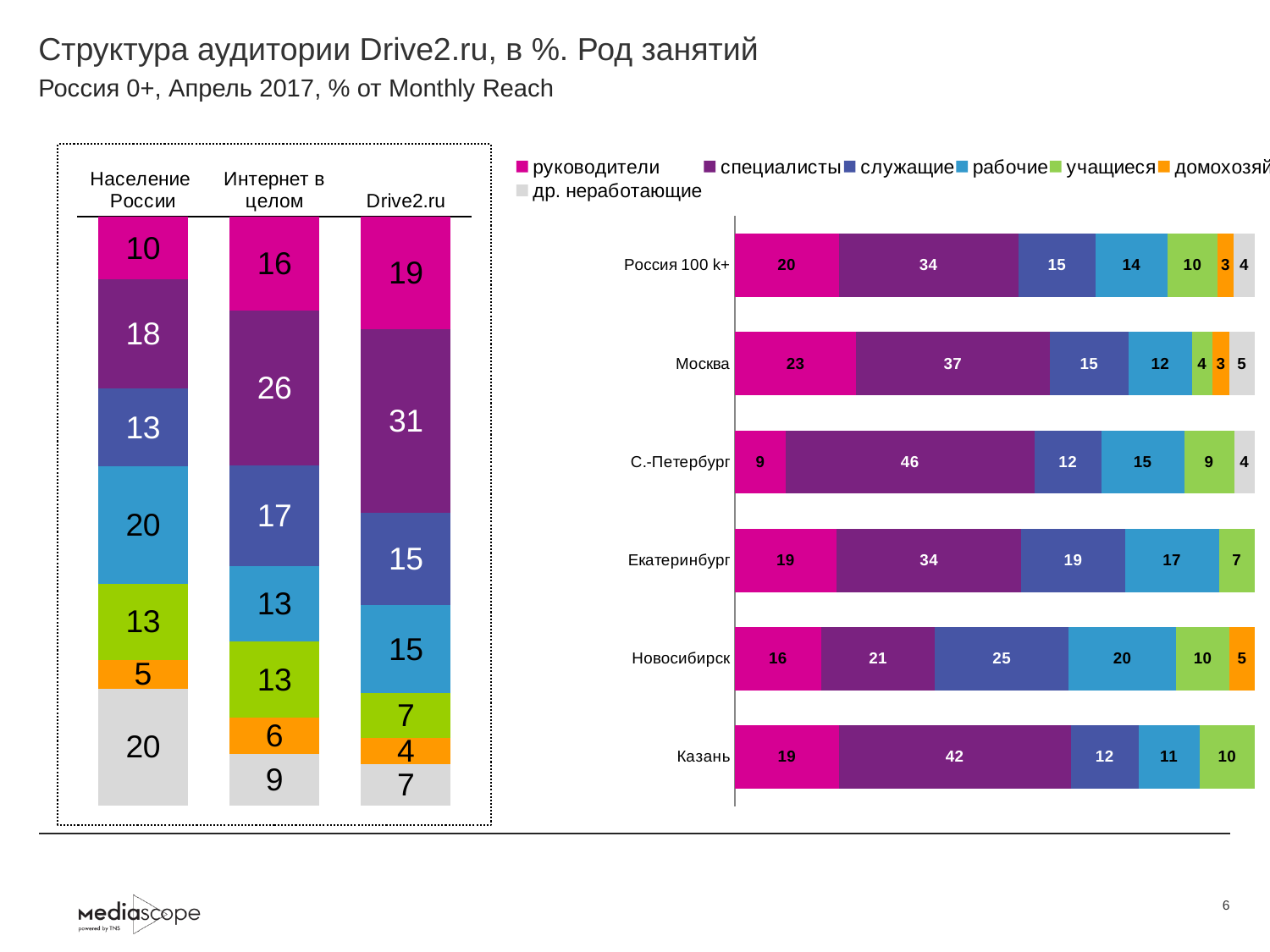
In the right chart, what is the специалисты value for С.-Петербург? 46 What type of chart is the right chart? Stacked bar chart In the left chart, is the др. неработающие (grey) value larger for Население России or for Drive2.ru? Население России In the right chart, what is the difference between the специалисты values for Казань and Новосибирск? 21 In the left chart, what is the difference between the специалисты values for Drive2.ru and Интернет в целом? 5 In the right chart, which city has the lowest руководители (pink) value? С.-Петербург How many series does the legend of the right chart list? 7 In the left chart, what is the value for специалисты (purple segment) in the Drive2.ru column? 31 In the left chart, which column has the largest рабочие (light blue) segment? Население России How many cities/regions are shown in the right chart? 6 In the right chart, which city has the highest руководители (pink) value? Москва In the left chart, what is the value for руководители (pink segment) in the Население России column? 10